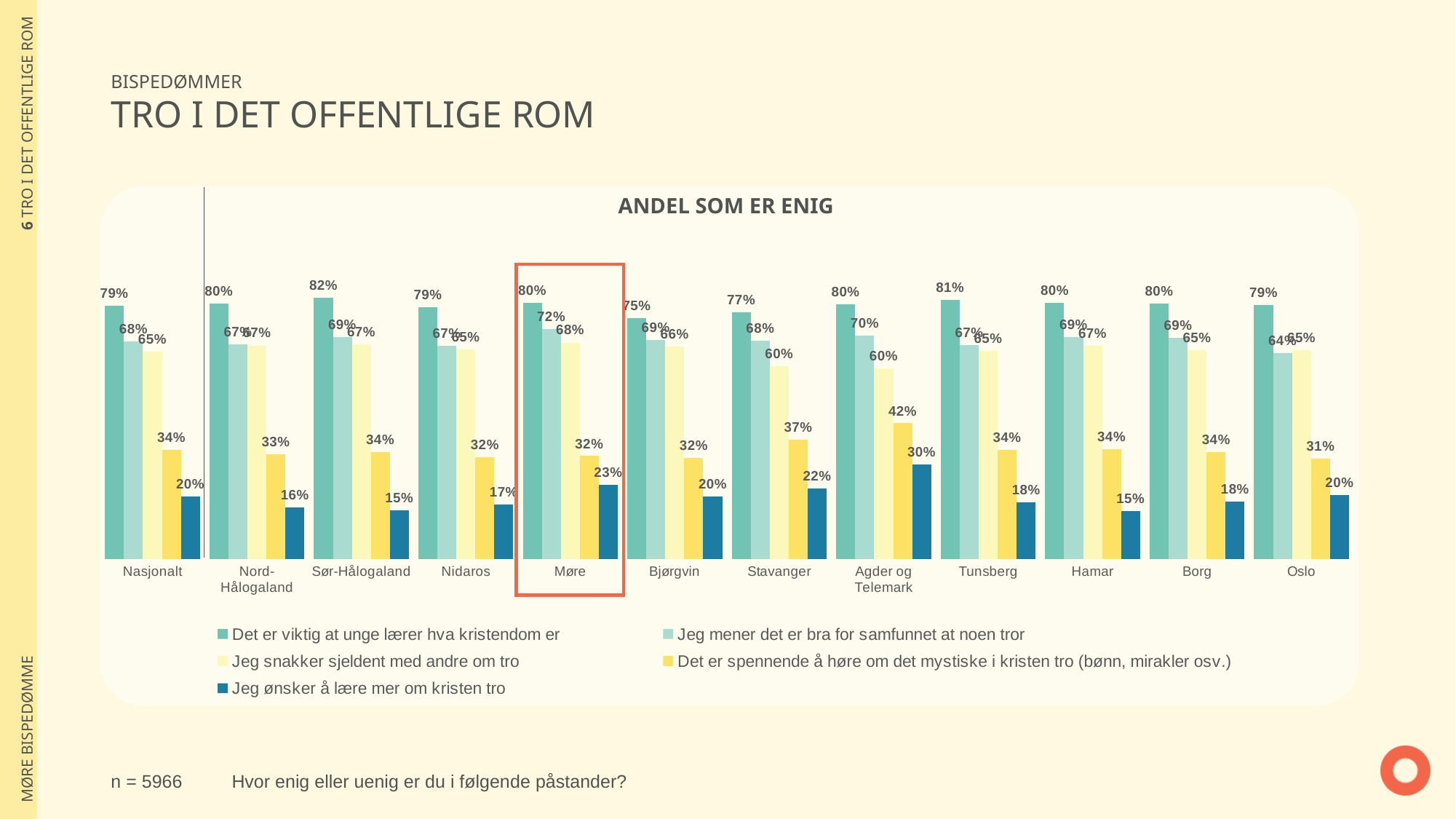
How many series does the legend list? 5 What is the value for Møre in the series "Jeg ønsker å lære mer om kristen tro"? 23% What kind of chart is shown on the slide? Bar chart Which category has the highest value for "Det er viktig at unge lærer hva kristendom er"? Sør-Hålogaland What is the value for Oslo in the series "Jeg mener det er bra for samfunnet at noen tror"? 64% What is the title of the chart? ANDEL SOM ER ENIG Which category has the highest value for "Jeg ønsker å lære mer om kristen tro"? Agder og Telemark Which category has the lowest value for "Det er viktig at unge lærer hva kristendom er"? Bjørgvin What is the value for Agder og Telemark in the series "Det er spennende å høre om det mystiske i kristen tro (bønn, mirakler osv.)"? 42% What is the difference between Møre and Nasjonalt for "Jeg mener det er bra for samfunnet at noen tror"? 4 percentage points Which is larger for "Det er spennende å høre om det mystiske i kristen tro (bønn, mirakler osv.)": Agder og Telemark or Stavanger? Agder og Telemark How many categories are shown on the x axis? 12